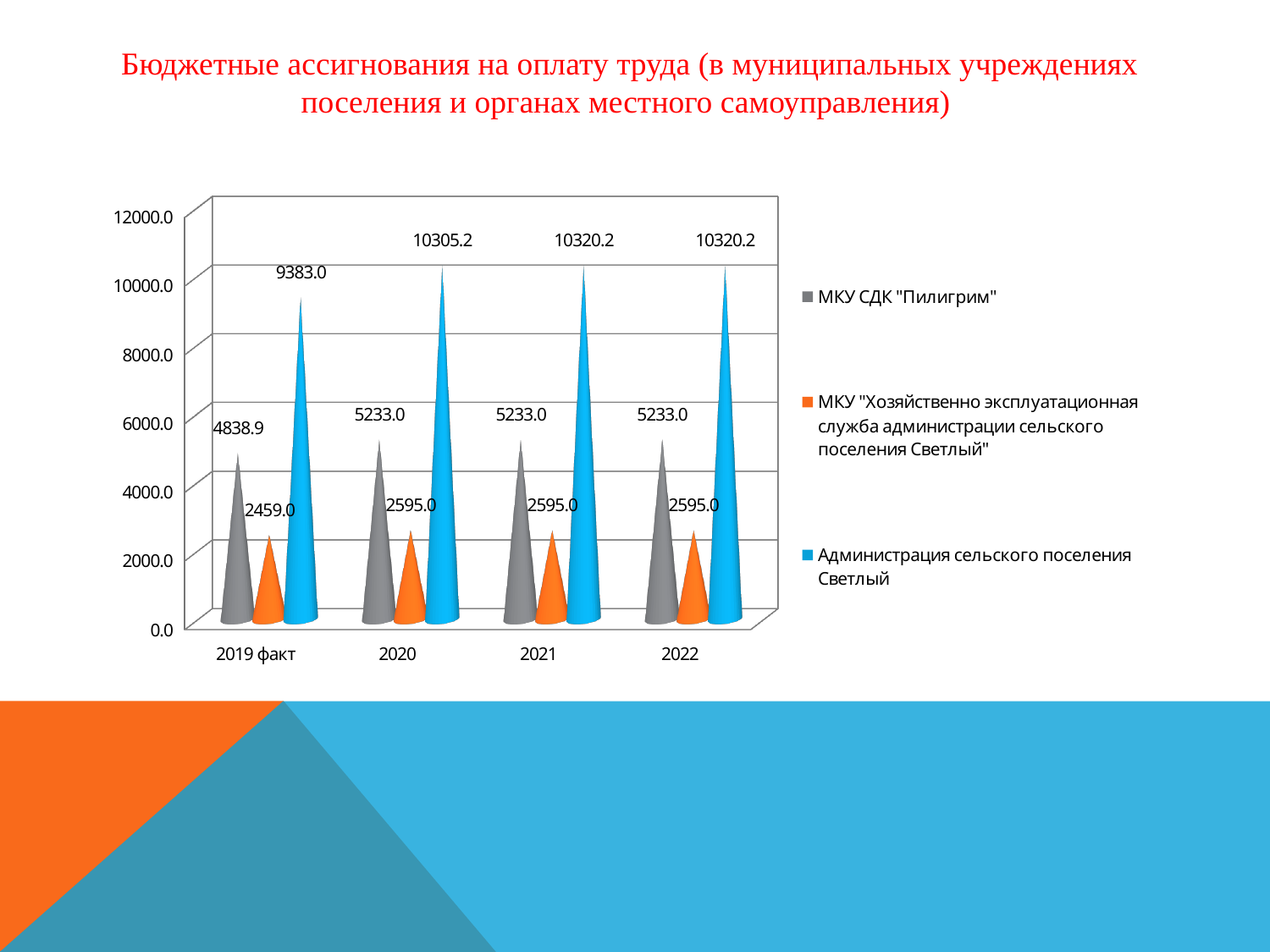
Does the value for Администрация сельского поселения Светлый rise or fall from 2019 факт to 2022? rise How many series does the legend list? 3 What is the value for МКУ "Хозяйственно эксплуатационная служба администрации сельского поселения Светлый" in 2019 факт? 2459.0 What is the value for Администрация сельского поселения Светлый in 2021? 10320.2 Which series has the lowest value in 2020? МКУ "Хозяйственно эксплуатационная служба администрации сельского поселения Светлый" What is the value for МКУ СДК "Пилигрим" in 2020? 5233.0 What is the value for Администрация сельского поселения Светлый in 2019 факт? 9383.0 What is the difference between the Администрация сельского поселения Светлый values for 2020 and 2019 факт? 922.2 Which series has the highest value in 2022? Администрация сельского поселения Светлый How many categories are shown on the x axis? 4 Which is larger: the МКУ СДК "Пилигрим" value in 2019 факт or in 2021? 2021 What kind of chart is shown on the slide? bar chart